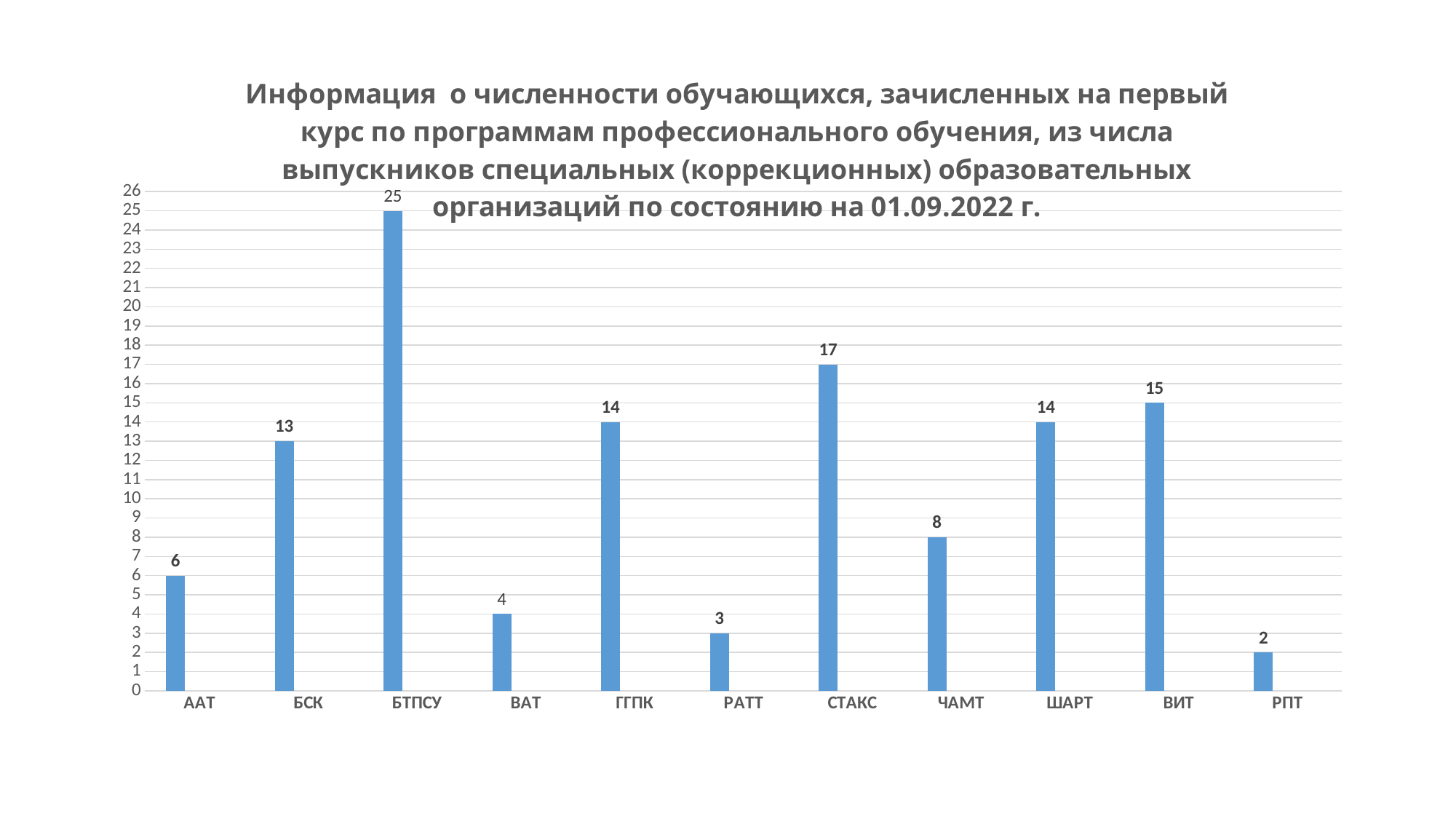
Which category has the highest value? БТПСУ What is the value for РПТ? 2 What is the value for СТАКС? 17 Is the value for ГГПК greater or less than 10? greater Which is larger, the value for БСК or the value for ВИТ? ВИТ What is the value for ЧАМТ? 8 How many categories are shown on the x axis? 11 What is the difference between the values for БТПСУ and СТАКС? 8 What is the value for БТПСУ? 25 What kind of chart is shown on the slide? bar chart What is the difference between the values for ВИТ and ААТ? 9 Which category has the lowest value? РПТ